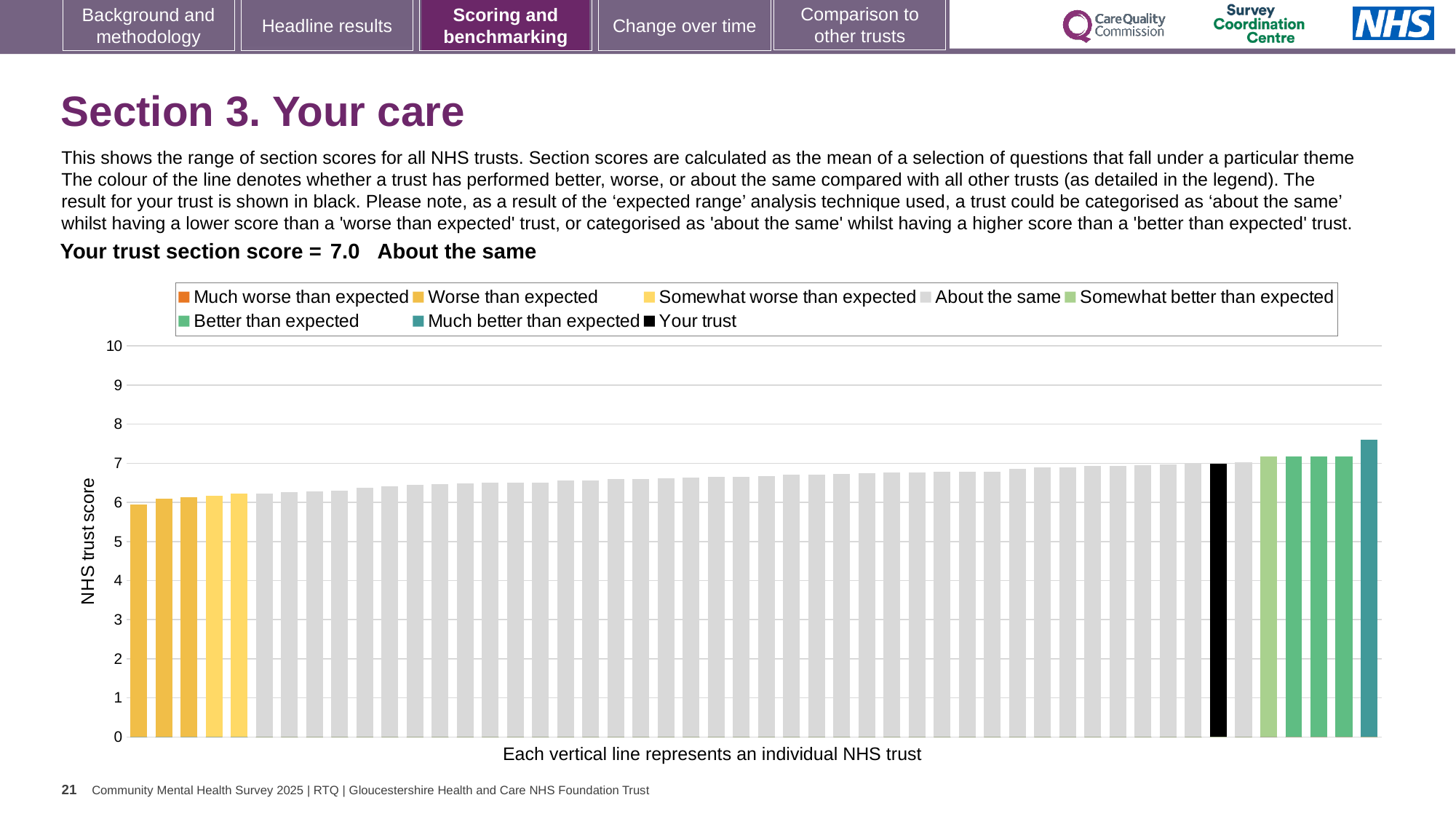
Is the value of the black 'Your trust' bar greater or less than 5? greater What kind of chart is shown on the slide? bar chart What is the label on the vertical axis of the chart? NHS trust score How many entries does the chart legend list? 8 Is the value of the tallest bar in the chart greater or less than 7? greater Do the bar values rise or fall moving from left to right along the x axis? rise What is the section score for your trust? 7.0 Is the value of the tallest bar in the chart greater or less than 8? less Which performance category is your trust placed in for Section 3? About the same How many bars are coloured as 'Much better than expected'? 1 What colour is used for the 'Your trust' bar in the chart? black